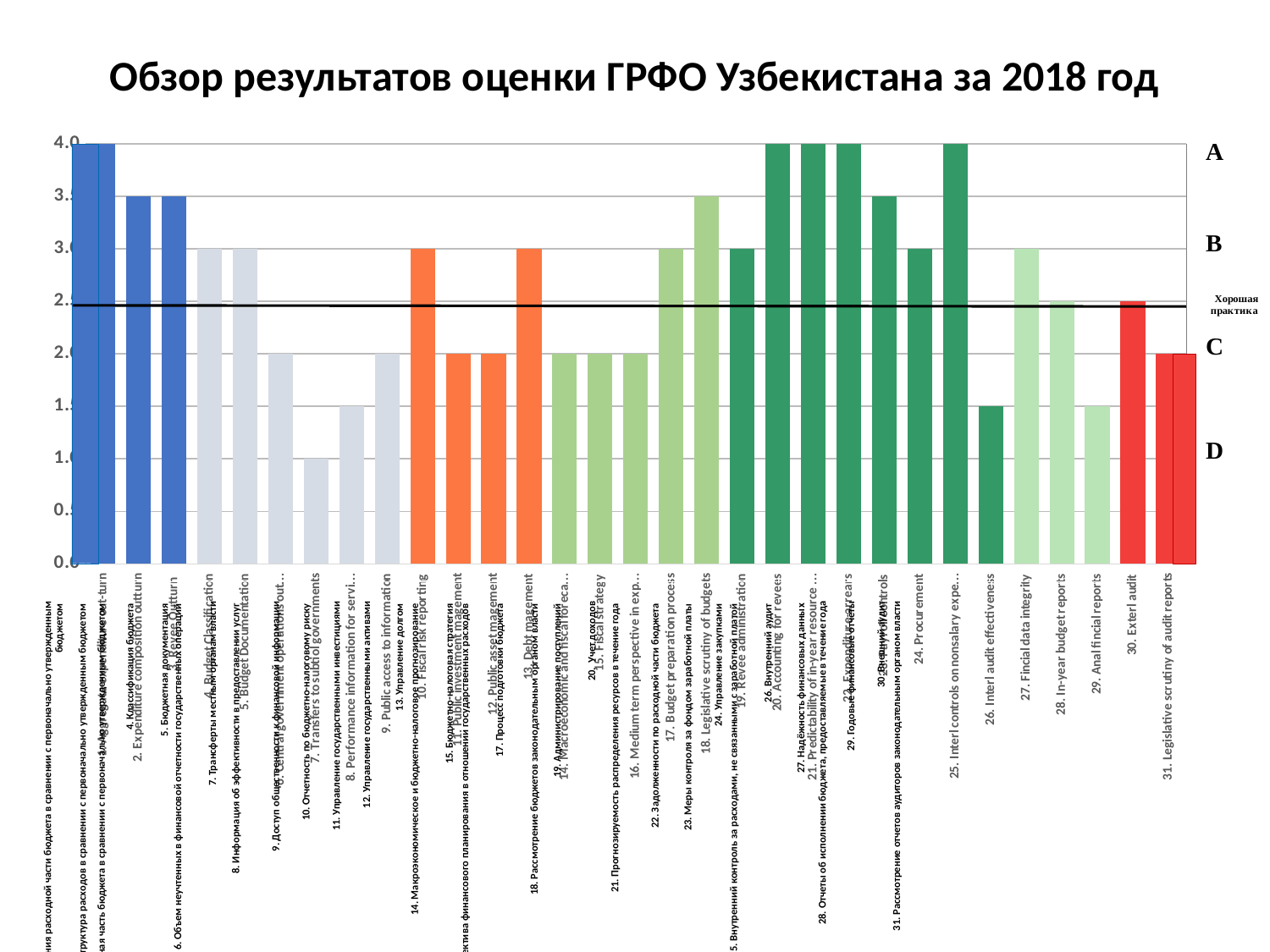
What is the title of the chart? Обзор результатов оценки ГРФО Узбекистана за 2018 год Which category has the lowest bar in the chart? 7. Transfers to subtiol governments How many bars are plotted in the chart? 31 What colour are the last two bars on the right of the chart? red What is the value for "31. Legislative scrutiny of audit reports"? 2.0 What is the difference between the values for "24. Procurement" and "26. Interl audit effectiveness"? 1.5 Which is larger, the value for "24. Procurement" or the value for "26. Interl audit effectiveness"? 24. Procurement What is the value for "24. Procurement"? 3.0 What type of chart is shown on the slide? bar chart What is the value for "26. Interl audit effectiveness"? 1.5 What is the value for "30. Exterl audit"? 2.5 Is the value for "29. Anal fincial reports" greater or less than 2.0? less